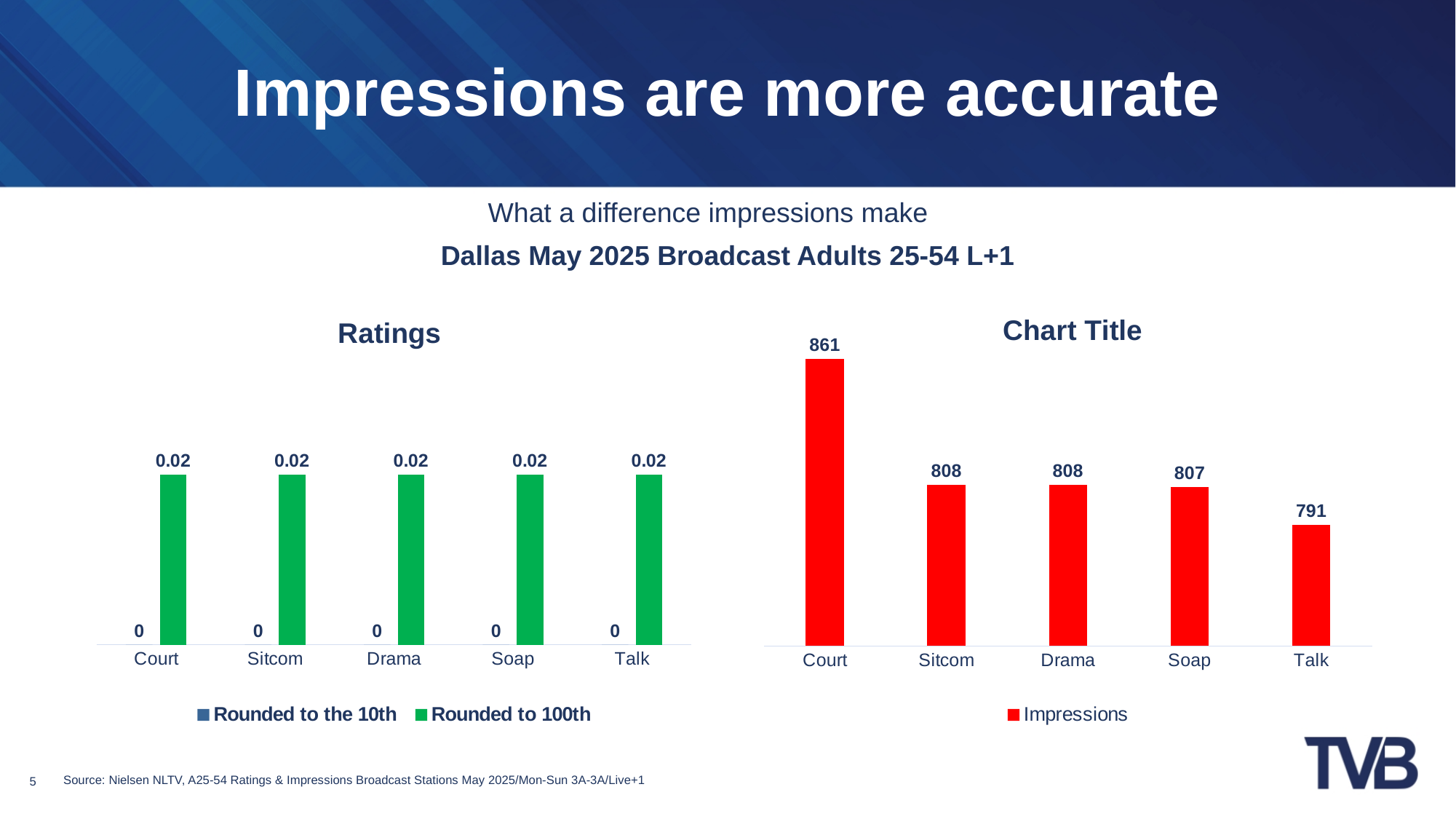
How many series does the legend of the 'Ratings' chart on the left list? 2 In the 'Chart Title' chart on the right, what is the Impressions value for Talk? 791 In the 'Chart Title' chart on the right, what is the difference between the Impressions for Court and Talk? 70 In the 'Chart Title' chart on the right, which category has the lowest Impressions value? Talk In the 'Chart Title' chart on the right, what is the Impressions value for Court? 861 In the 'Ratings' chart on the left, what is the 'Rounded to the 10th' value for Sitcom? 0 In the 'Chart Title' chart on the right, which is larger, the Impressions for Court or for Soap? Court In the 'Ratings' chart on the left, what is the 'Rounded to 100th' value for Drama? 0.02 What colour are the bars in the 'Chart Title' chart on the right? Red What kind of chart is the 'Chart Title' chart on the right? Bar chart In the 'Chart Title' chart on the right, which category has the highest Impressions value? Court How many categories are shown on the x axis of the 'Ratings' chart on the left? 5